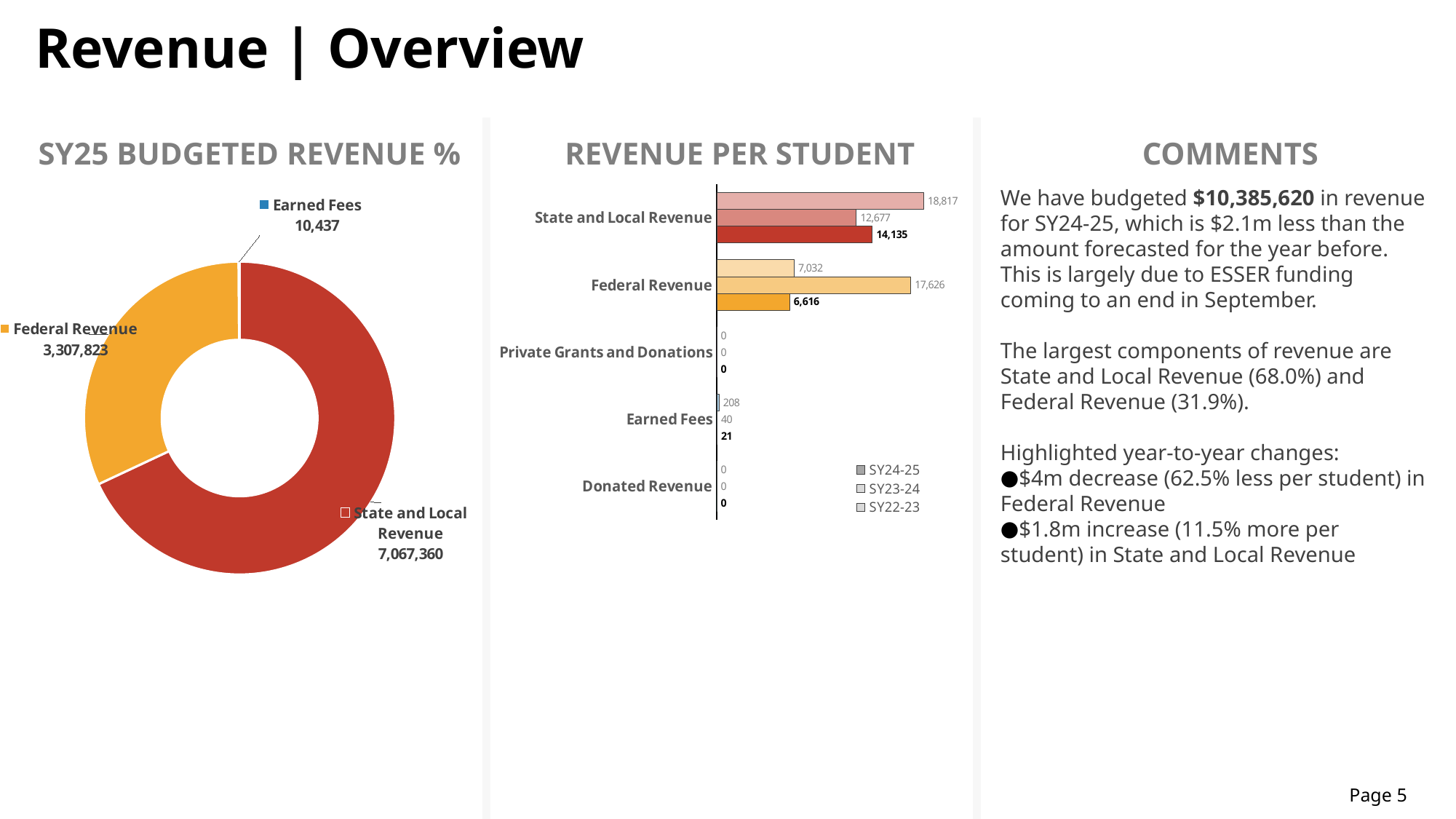
How many categories are shown in the REVENUE PER STUDENT chart? 5 In the SY25 BUDGETED REVENUE % chart, what is the difference between State and Local Revenue and Federal Revenue? 3,759,537 In the REVENUE PER STUDENT chart, what is the SY24-25 value for State and Local Revenue? 14,135 In the REVENUE PER STUDENT chart, what is the SY24-25 value for Earned Fees? 21 In the SY25 BUDGETED REVENUE % chart, what is the value for Earned Fees? 10,437 In the SY25 BUDGETED REVENUE % chart, which category has the smallest slice? Earned Fees What kind of chart is the SY25 BUDGETED REVENUE % chart? Doughnut (pie) chart In the SY25 BUDGETED REVENUE % chart, what is the value for State and Local Revenue? 7,067,360 In the SY25 BUDGETED REVENUE % chart, which category has the largest slice? State and Local Revenue In the REVENUE PER STUDENT chart, what is the SY24-25 value for Federal Revenue? 6,616 How many series does the legend of the REVENUE PER STUDENT chart list? 3 What kind of chart is the REVENUE PER STUDENT chart? Bar chart